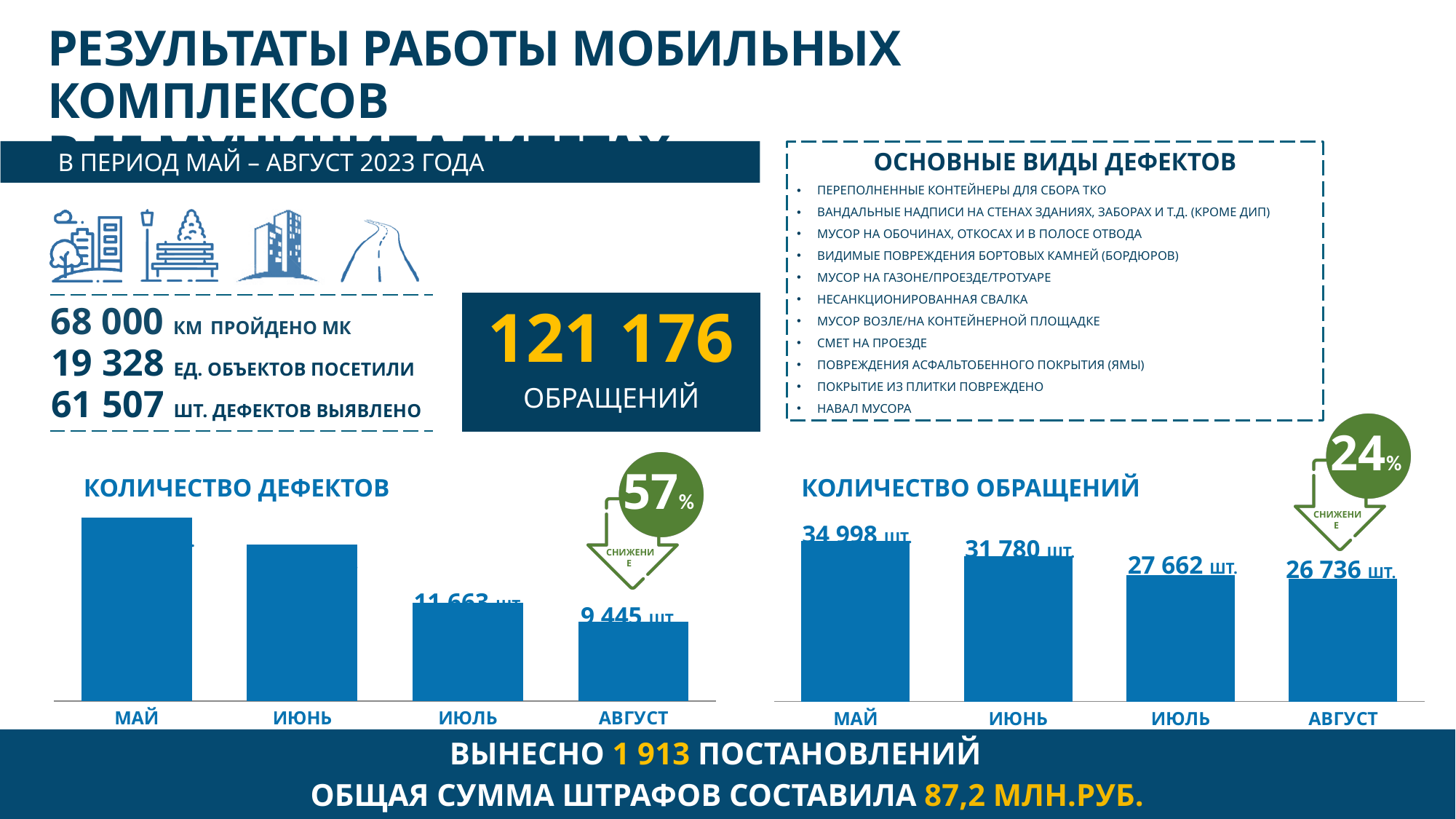
In the chart titled КОЛИЧЕСТВО ОБРАЩЕНИЙ, which month has the lowest value? АВГУСТ In the chart titled КОЛИЧЕСТВО ОБРАЩЕНИЙ, what is the value for ИЮЛЬ? 27 662 шт. What kind of chart is the chart titled КОЛИЧЕСТВО ДЕФЕКТОВ? Bar chart In the chart titled КОЛИЧЕСТВО ДЕФЕКТОВ, what is the value for АВГУСТ? 9 445 шт. In the chart titled КОЛИЧЕСТВО ДЕФЕКТОВ, which month has the highest value? МАЙ What percentage decrease is shown in the green arrow next to the chart titled КОЛИЧЕСТВО ДЕФЕКТОВ? 57% In the chart titled КОЛИЧЕСТВО ОБРАЩЕНИЙ, what is the value for АВГУСТ? 26 736 шт. In the chart titled КОЛИЧЕСТВО ДЕФЕКТОВ, which is larger, the value for ИЮНЬ or the value for ИЮЛЬ? ИЮНЬ In the chart titled КОЛИЧЕСТВО ОБРАЩЕНИЙ, what is the value for МАЙ? 34 998 шт. How many months are shown in the chart titled КОЛИЧЕСТВО ОБРАЩЕНИЙ? 4 In the chart titled КОЛИЧЕСТВО ОБРАЩЕНИЙ, do the values rise or fall from МАЙ to АВГУСТ? Fall In the chart titled КОЛИЧЕСТВО ОБРАЩЕНИЙ, what is the difference between the values for МАЙ and ИЮНЬ? 3 218 шт.